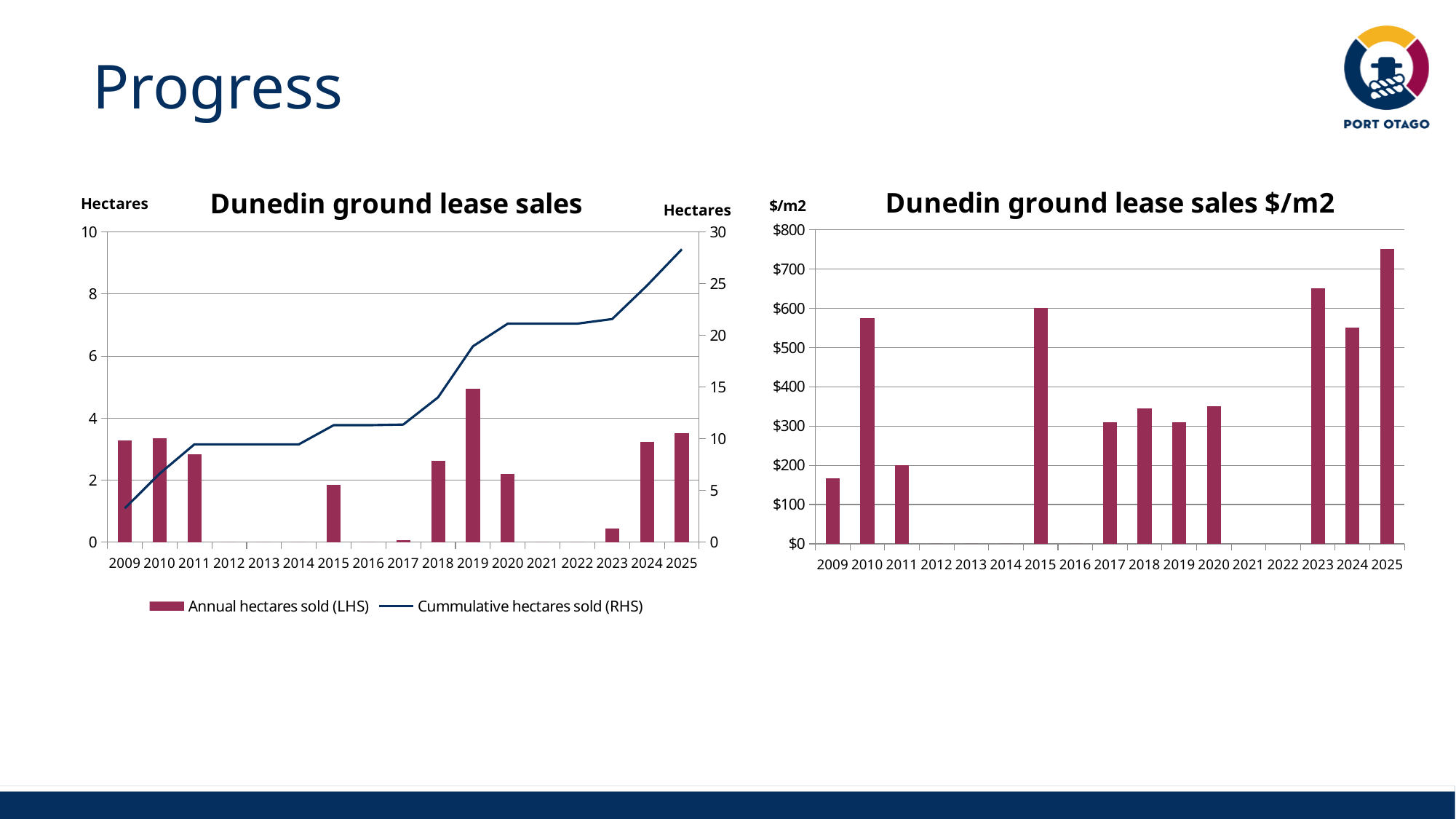
On the chart titled "Dunedin ground lease sales $/m2", how many years are shown on the x axis? 17 On the chart titled "Dunedin ground lease sales $/m2", which year with a bar has the lowest value? 2009 On the chart titled "Dunedin ground lease sales", which year has the highest annual hectares sold bar? 2019 On the chart titled "Dunedin ground lease sales", is the cumulative hectares sold value for 2025 greater or less than 25? greater On the chart titled "Dunedin ground lease sales", which series is plotted as a line? Cummulative hectares sold (RHS) On the chart titled "Dunedin ground lease sales $/m2", is the value for 2025 greater or less than $700? greater On the chart titled "Dunedin ground lease sales", is the annual hectares sold value for 2015 greater or less than 2? less On the chart titled "Dunedin ground lease sales $/m2", which year has the highest value? 2025 On the chart titled "Dunedin ground lease sales", how many series does the legend list? 2 On the chart titled "Dunedin ground lease sales", does the cumulative hectares sold line rise or fall from 2009 to 2025? rise On the chart titled "Dunedin ground lease sales $/m2", which is larger, the value for 2023 or the value for 2024? 2023